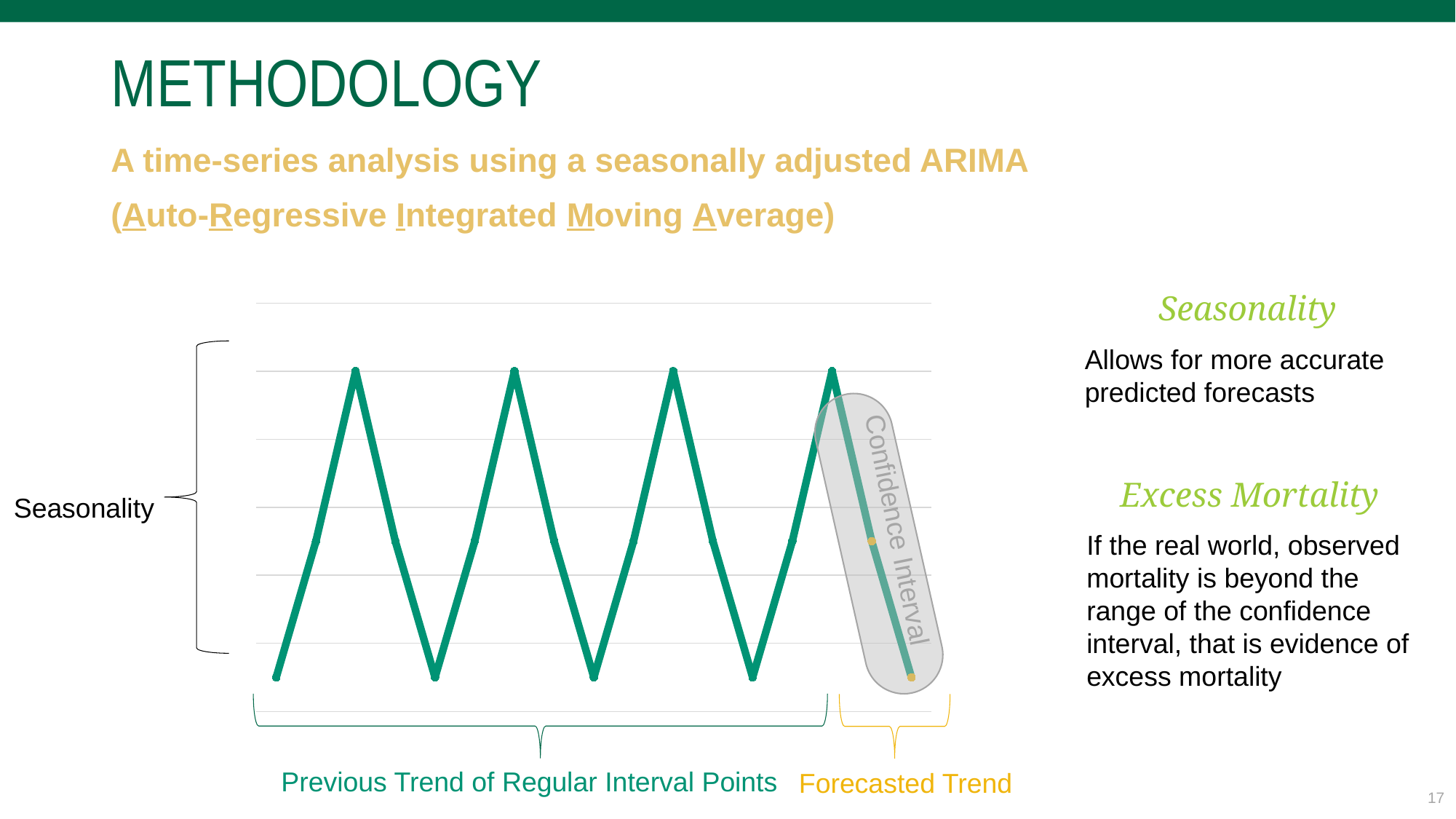
How many yellow points are plotted on the forecasted trend segment? 2 What kind of chart is shown on the slide? line chart Does the forecasted trend segment at the right of the chart rise or fall? fall How many peaks does the green line reach in the chart? 4 What label is written inside the shaded region at the right of the chart? Confidence Interval What label appears under the bracket spanning the green portion of the chart? Previous Trend of Regular Interval Points